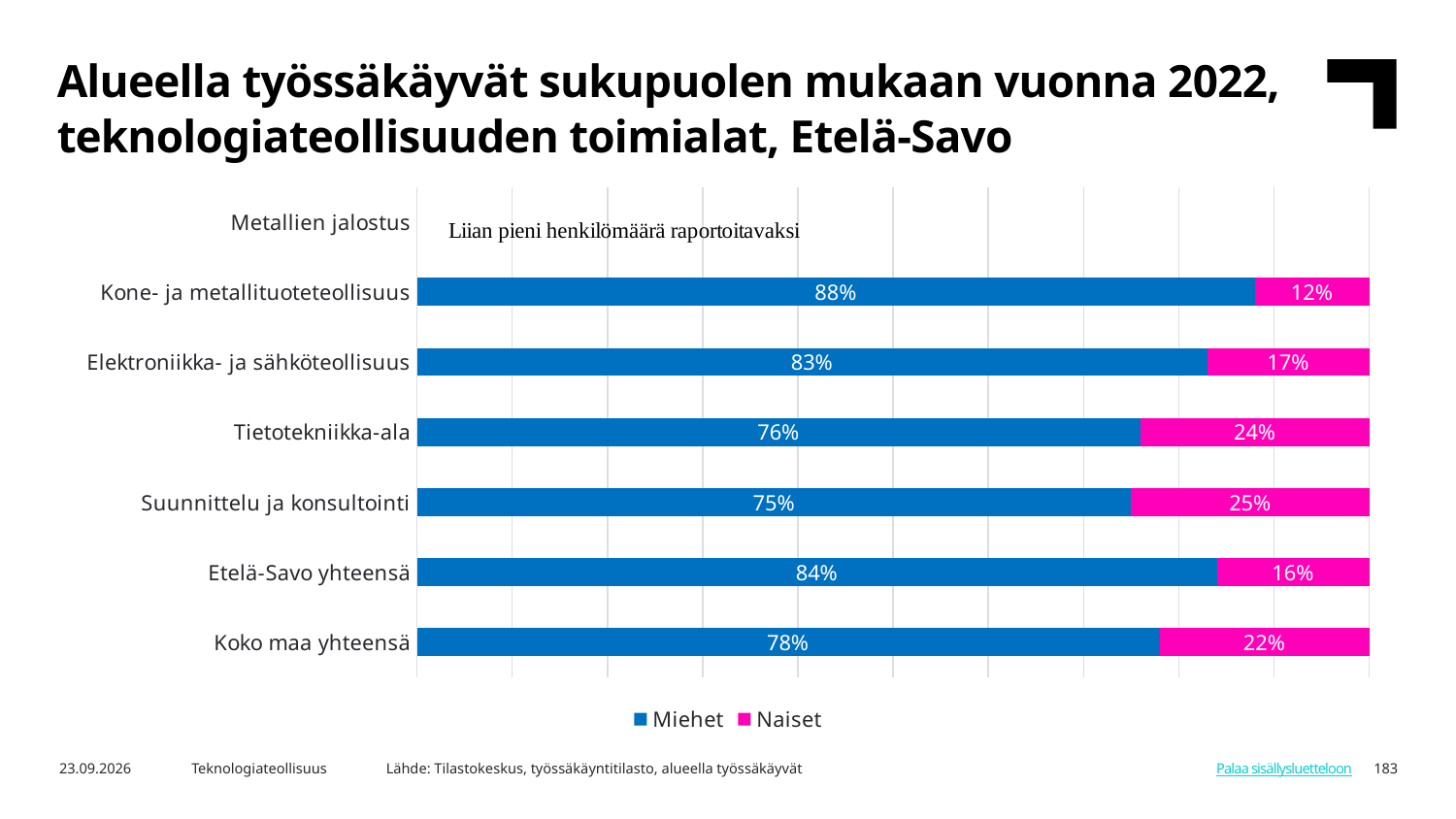
How many series does the legend list? 2 What is the Miehet share for Kone- ja metallituoteteollisuus? 88% What kind of chart is shown on the slide? Stacked bar chart What is the total of the stacked bar for Tietotekniikka-ala? 100% Which category has the highest Naiset share? Suunnittelu ja konsultointi Which is larger: the Naiset share for Koko maa yhteensä or for Etelä-Savo yhteensä? Koko maa yhteensä What is the Miehet share for Koko maa yhteensä? 78% What is the Naiset share for Tietotekniikka-ala? 24% What text is shown instead of a bar for Metallien jalostus? Liian pieni henkilömäärä raportoitavaksi What is the difference between the Miehet share for Kone- ja metallituoteteollisuus and for Elektroniikka- ja sähköteollisuus? 5 percentage points Which category has the lowest Miehet share? Suunnittelu ja konsultointi What is the Naiset share for Etelä-Savo yhteensä? 16%